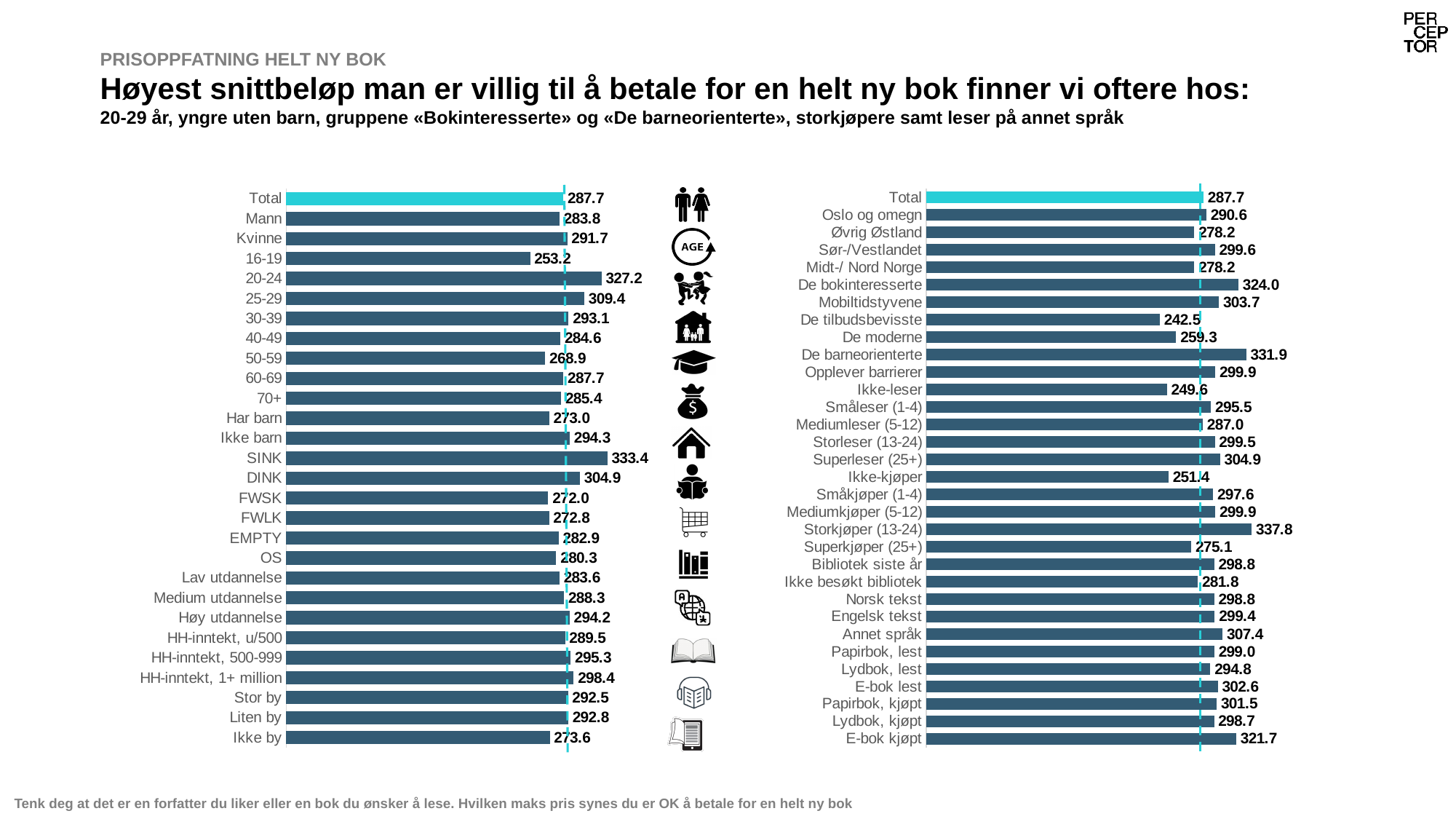
In the left chart, which category has the lowest value? 16-19 How many categories are plotted in the right chart? 32 In the left chart, what is the value for SINK? 333.4 What kind of chart is the left chart? Bar chart In the left chart, what is the difference between the values for 20-24 and 25-29? 17.8 In the right chart, which category has the lowest value? De tilbudsbevisste In the left chart, which is larger, the value for Har barn or the value for Ikke barn? Ikke barn In the right chart, which category has the highest value? Storkjøper (13-24) In the left chart, what is the value for 16-19? 253.2 In the right chart, what is the value for Storkjøper (13-24)? 337.8 In the right chart, what is the difference between the values for De barneorienterte and De bokinteresserte? 7.9 In the left chart, which category has the highest value? SINK